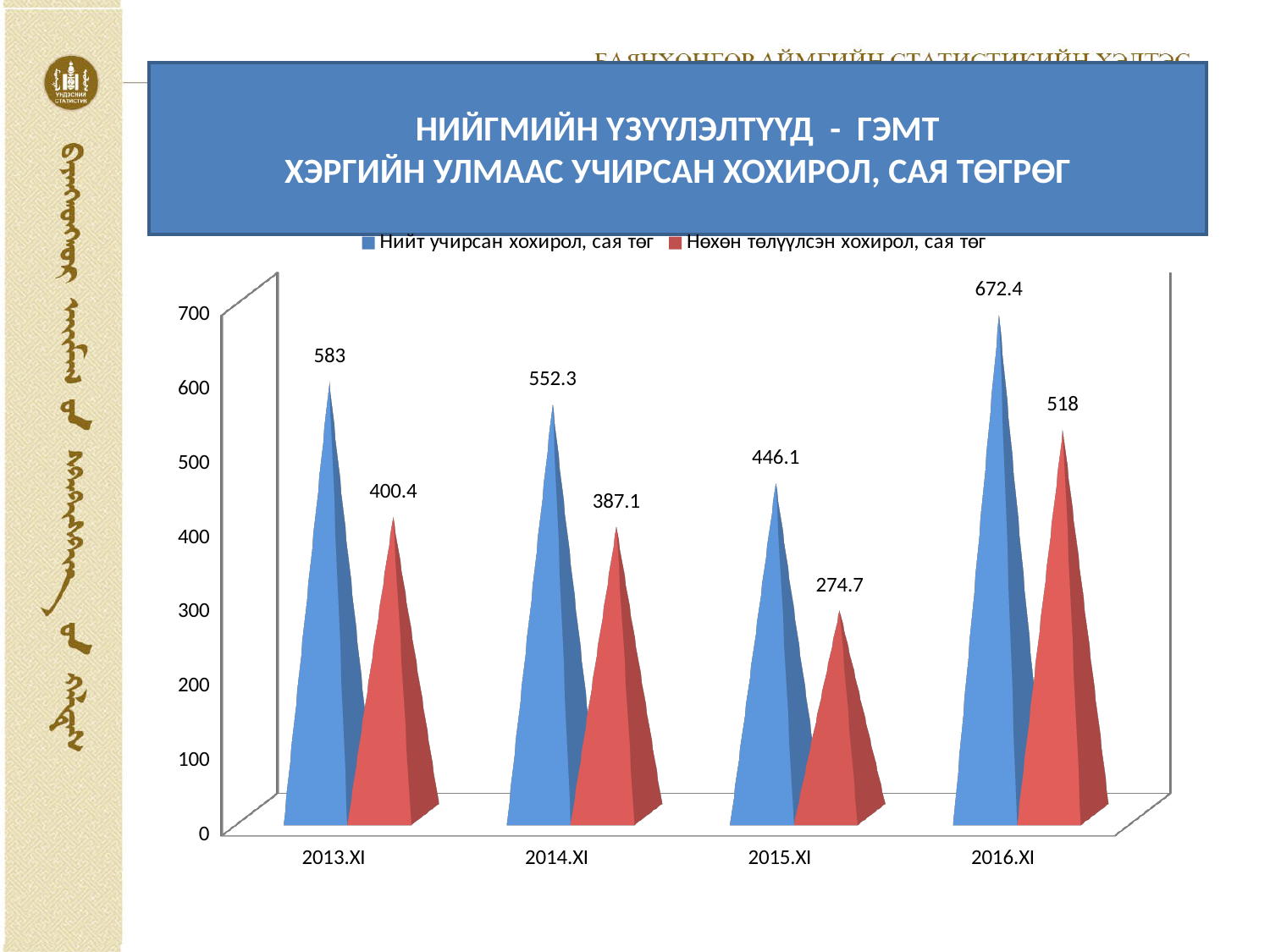
How many periods are shown on the x axis? 4 What is the value of Нөхөн төлүүлсэн хохирол, сая төг for 2013.XI? 400.4 Which period has the lowest value for Нөхөн төлүүлсэн хохирол, сая төг? 2015.XI Is the value of Нөхөн төлүүлсэн хохирол, сая төг for 2016.XI greater or less than 500? greater What is the value of Нийт учирсан хохирол, сая төг for 2016.XI? 672.4 Which is larger: Нийт учирсан хохирол in 2013.XI or Нийт учирсан хохирол in 2014.XI? 2013.XI What is the difference between Нийт учирсан хохирол and Нөхөн төлүүлсэн хохирол in 2014.XI? 165.2 Which period has the highest value for Нийт учирсан хохирол, сая төг? 2016.XI How many series does the legend list? 2 Which colour represents Нөхөн төлүүлсэн хохирол, сая төг in the chart? red What kind of chart is shown on the slide? bar chart What is the value of Нөхөн төлүүлсэн хохирол, сая төг for 2015.XI? 274.7